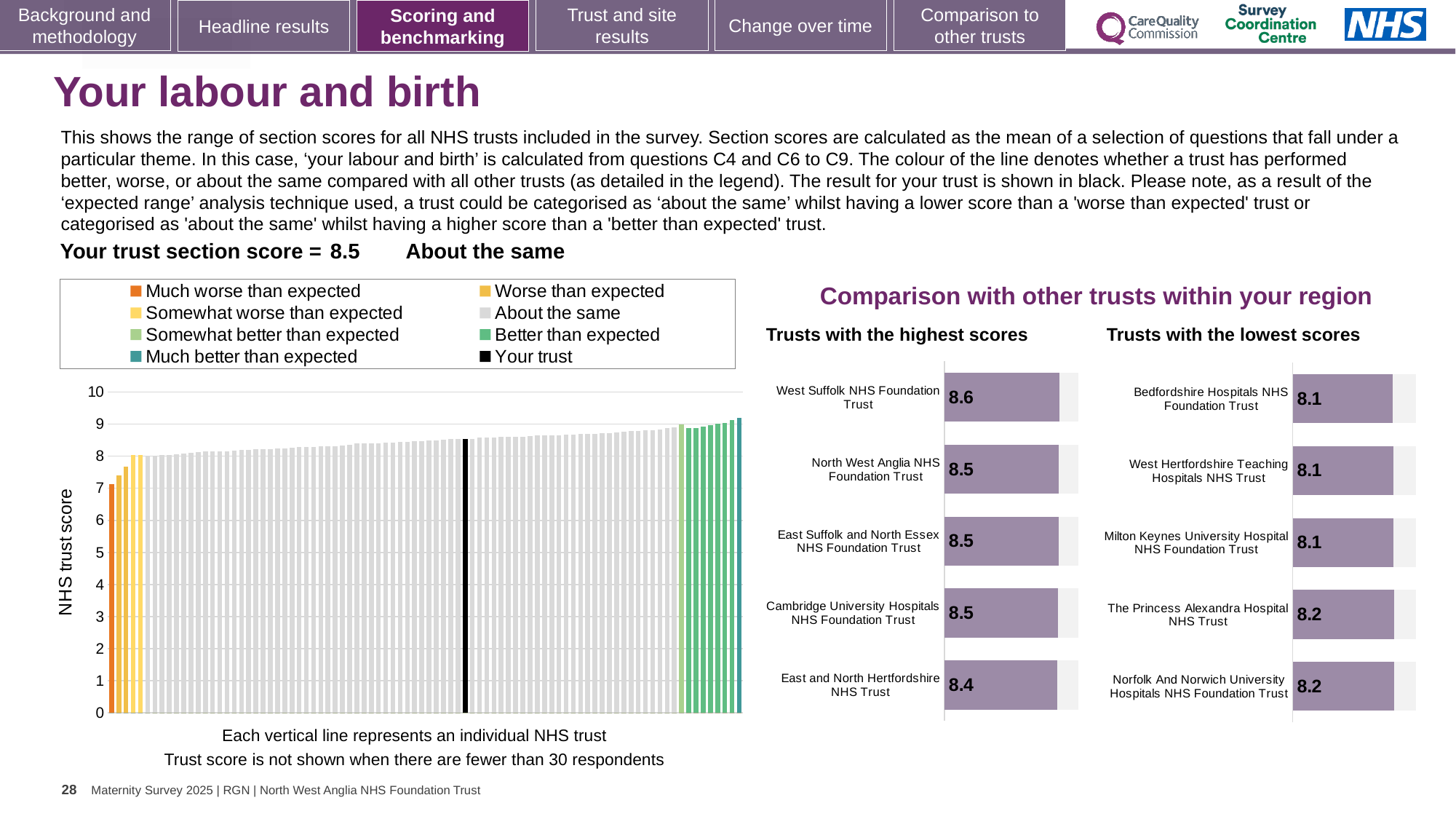
On the 'Trusts with the highest scores' chart, which trust has the lowest score? East and North Hertfordshire NHS Trust On the 'NHS trust score' chart on the left, is the value of the tallest bar greater or less than 9? greater On the 'Trusts with the highest scores' chart, which trust has the highest score? West Suffolk NHS Foundation Trust On the 'Trusts with the lowest scores' chart, what is the score for The Princess Alexandra Hospital NHS Trust? 8.2 Which is larger: the score for West Suffolk NHS Foundation Trust on the 'Trusts with the highest scores' chart or the score for Bedfordshire Hospitals NHS Foundation Trust on the 'Trusts with the lowest scores' chart? West Suffolk NHS Foundation Trust On the 'Trusts with the highest scores' chart, what is the score for West Suffolk NHS Foundation Trust? 8.6 What kind of chart is the 'NHS trust score' chart on the left? Bar chart How many trusts are shown on the 'Trusts with the lowest scores' chart? 5 On the 'NHS trust score' chart on the left, do the bar values rise or fall from left to right? Rise How many entries does the legend of the 'NHS trust score' chart on the left list? 8 On the 'NHS trust score' chart on the left, what colour does the legend use for 'Your trust'? Black On the 'Trusts with the highest scores' chart, what is the difference between the scores of West Suffolk NHS Foundation Trust and East and North Hertfordshire NHS Trust? 0.2